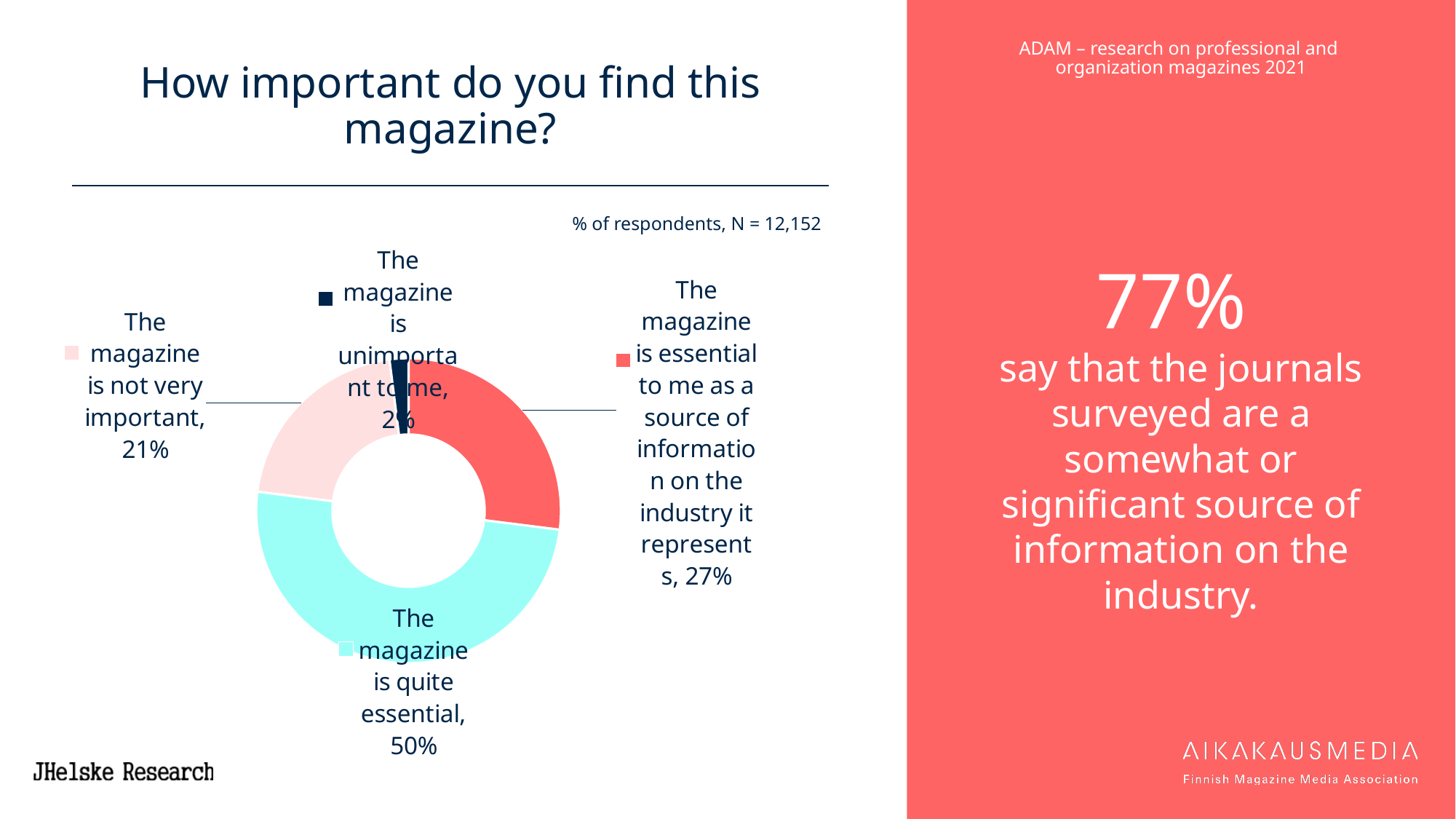
How many response categories are shown in the chart? 4 What share of respondents say the magazine is quite essential? 50% Which is larger: the share saying the magazine is essential or the share saying it is not very important? The magazine is essential Which response category has the largest share of respondents? The magazine is quite essential What is the difference in percentage points between the 'quite essential' share and the 'essential' share? 23 percentage points What share of respondents say the magazine is not very important? 21% What share of respondents say the magazine is unimportant to them? 2% What is the combined share of respondents who say the magazine is essential or quite essential? 77% Which response category has the smallest share of respondents? The magazine is unimportant to me What share of respondents say the magazine is essential to them as a source of information on the industry it represents? 27% What kind of chart is shown on the slide? Doughnut (pie) chart What is the number of respondents (N) stated on the slide? 12,152